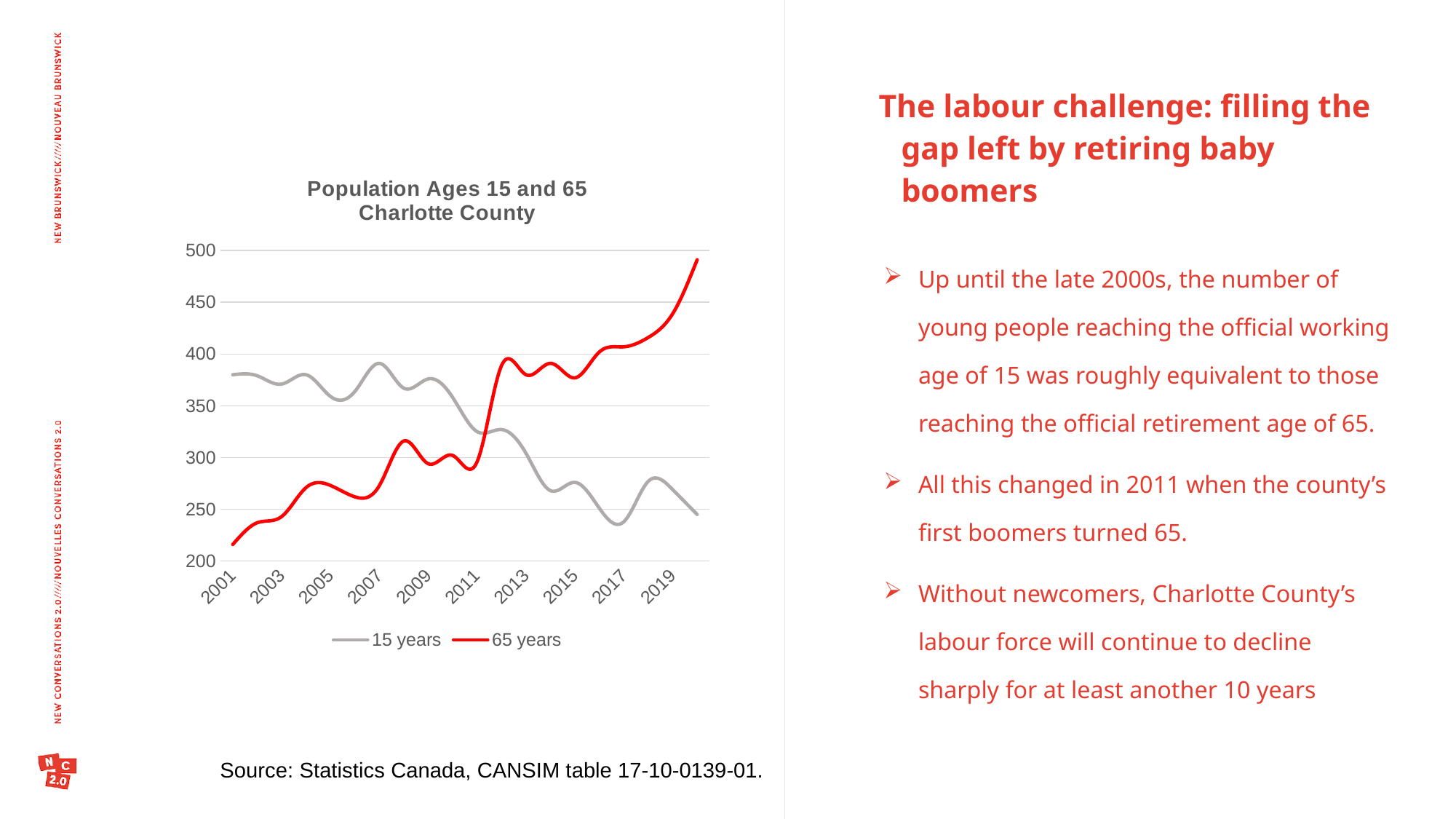
In 2001, which series has the larger value, 15 years or 65 years? 15 years What is the title of the chart? Population Ages 15 and 65 Charlotte County In 2019, which series has the larger value, 15 years or 65 years? 65 years Is the value for 65 years at the last point on the chart greater or less than 450? greater Does the 65 years series generally rise or fall from 2001 to the end of the chart? rise Does the 15 years series generally rise or fall from 2001 to the end of the chart? fall How many series does the legend list? 2 What kind of chart is shown on the slide? line chart Is the value for 65 years in 2001 greater or less than 250? less Is the value for 15 years in 2001 greater or less than 350? greater How many year labels are shown on the x axis? 10 What are the two series named in the legend? 15 years and 65 years